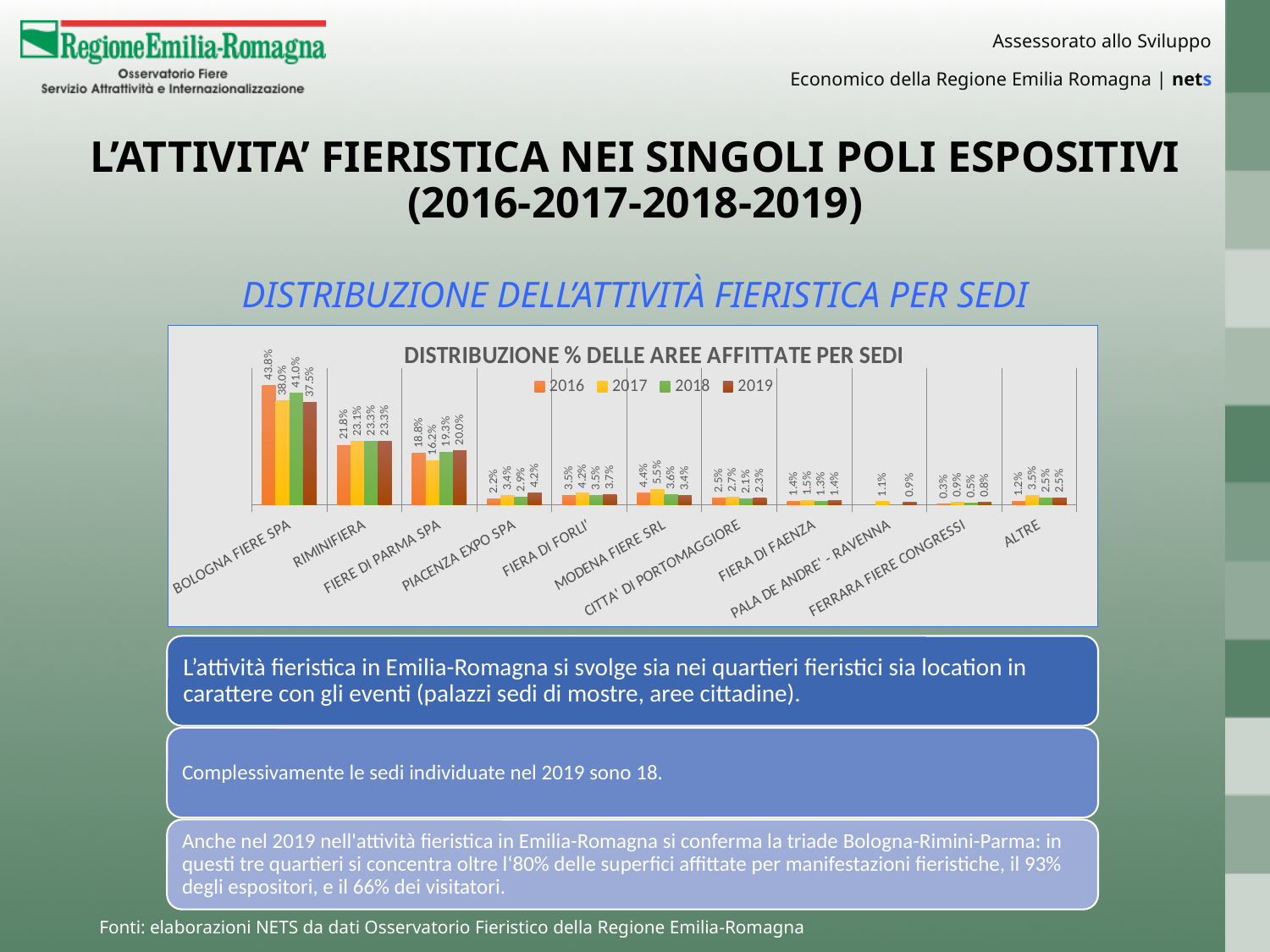
Which venue has the lowest value in 2016? FERRARA FIERE CONGRESSI What is the value for FIERE DI PARMA SPA in 2019? 20.0% Which venue has the highest value in 2019? BOLOGNA FIERE SPA Which is larger for PIACENZA EXPO SPA: the 2017 value or the 2019 value? 2019 What is the difference between the 2016 and 2019 values for BOLOGNA FIERE SPA? 6.3% What kind of chart is shown on the slide? Bar chart How many venue categories are shown on the x axis? 11 What is the value for BOLOGNA FIERE SPA in 2016? 43.8% How many series does the legend list? 4 What is the value for RIMINIFIERA in 2017? 23.1% What is the title of the chart? DISTRIBUZIONE % DELLE AREE AFFITTATE PER SEDI What is the value for MODENA FIERE SRL in 2018? 3.6%